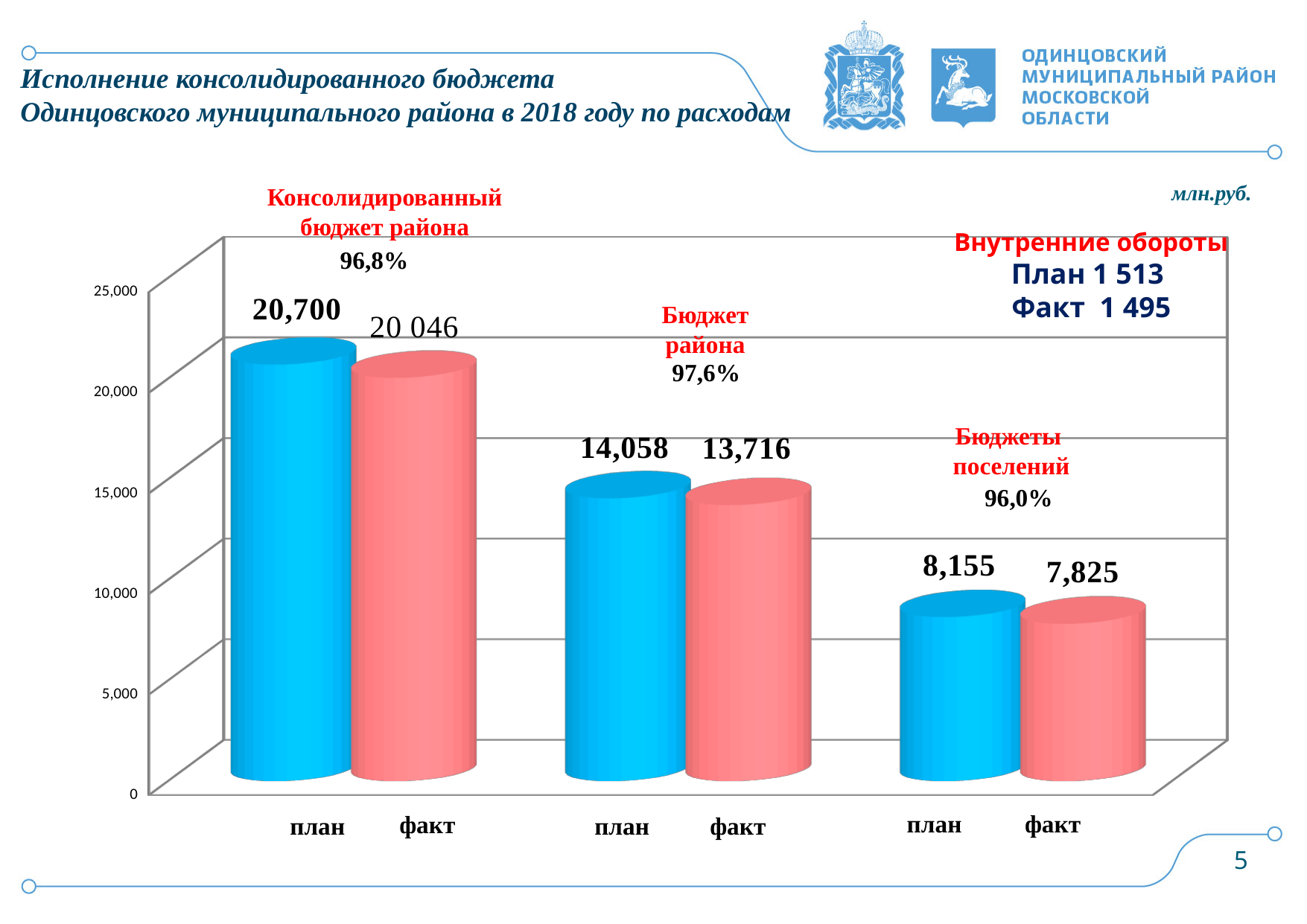
What kind of chart is shown on the slide? bar chart What is the difference between the plan and actual values for the district budget (Бюджет района)? 342 Which is larger for the settlement budgets (Бюджеты поселений): the plan or the actual value? план (8,155) What is the actual (факт) value for the consolidated district budget (Консолидированный бюджет района)? 20 046 What is the actual (факт) value for the settlement budgets (Бюджеты поселений)? 7,825 What is the plan (план) value for the district budget (Бюджет района)? 14,058 What unit of measurement is indicated for the chart values? млн.руб. Which bar has the highest value on the chart? план, Консолидированный бюджет района (20,700) What is the plan (план) value for the consolidated district budget (Консолидированный бюджет района)? 20,700 How many bars are plotted on the chart? 6 What execution percentage is shown for the district budget (Бюджет района)? 97,6% Which bar has the lowest value on the chart? факт, Бюджеты поселений (7,825)